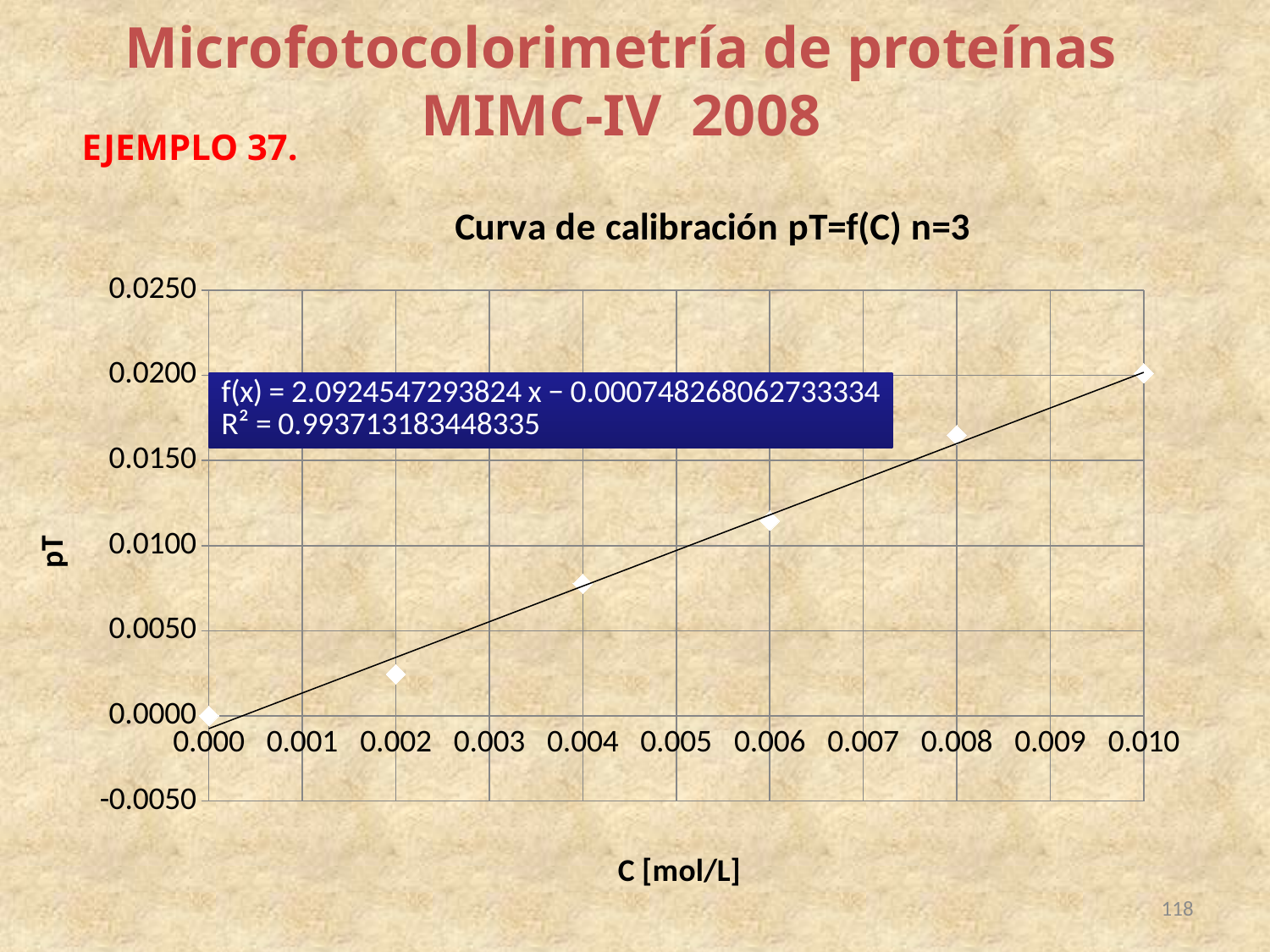
Is the pT value at C = 0.006 greater or less than 0.0150? less Which has the larger pT value: the point at C = 0.002 or the point at C = 0.006? C = 0.006 What is the title of the chart? Curva de calibración pT=f(C) n=3 What kind of chart is shown on the slide? Scatter chart with a trendline At which C value is the plotted pT lowest? 0.000 What R² value is shown for the trendline on the chart? 0.993713183448335 Is the pT value at C = 0.004 greater or less than 0.0050? greater What is the label of the x axis of the chart? C [mol/L] How many data points are plotted on the chart? 6 At which C value is the plotted pT highest? 0.010 Is the pT value at C = 0.008 greater or less than 0.0150? greater Do the pT values rise or fall as C increases along the x axis? Rise